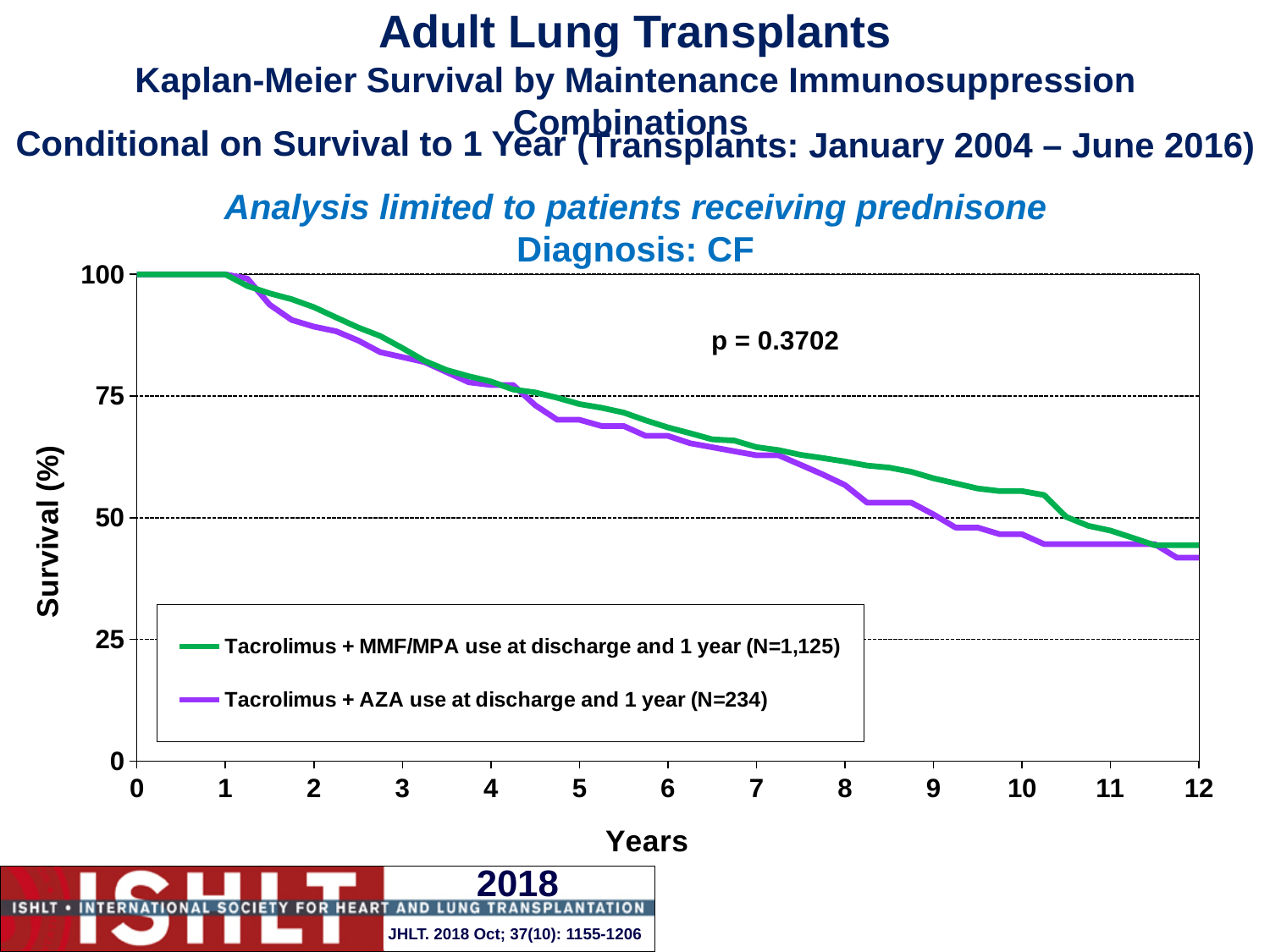
What is the label of the y axis? Survival (%) How many series does the legend list? 2 Do the survival curves rise or fall as years increase? fall What is the N for the Tacrolimus + MMF/MPA use at discharge and 1 year group? N=1,125 At 10 years, which group has the higher survival, Tacrolimus + MMF/MPA or Tacrolimus + AZA? Tacrolimus + MMF/MPA Is the survival value for the Tacrolimus + MMF/MPA group at 8 years greater or less than 50? greater Is the survival value for the Tacrolimus + MMF/MPA group at 10 years greater or less than 50? greater Is the survival value for the Tacrolimus + AZA group at 12 years greater or less than 50? less What is the p-value printed on the chart? p = 0.3702 What kind of chart is shown on the slide? line chart What is the N for the Tacrolimus + AZA use at discharge and 1 year group? N=234